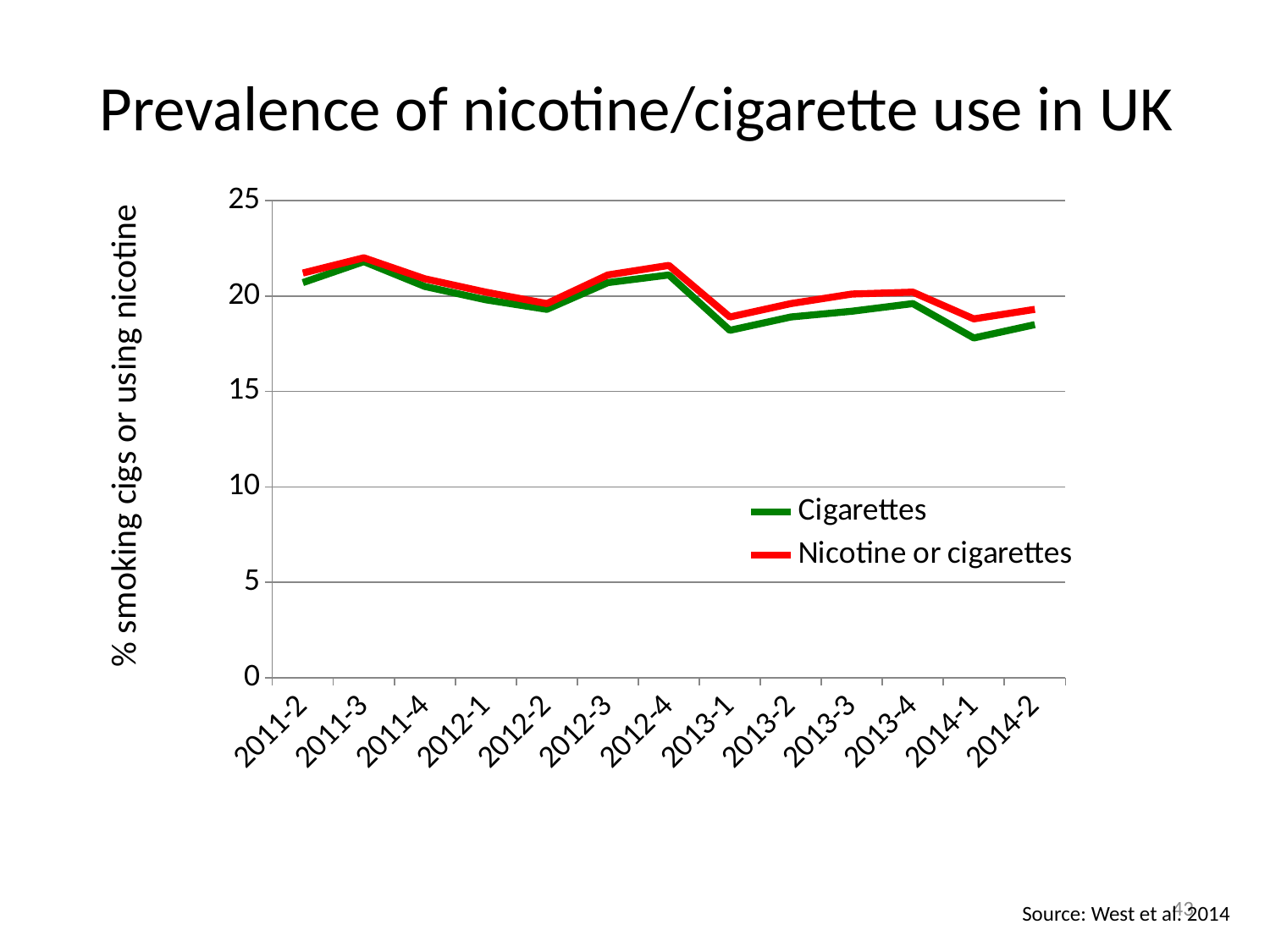
Is the value for Nicotine or cigarettes in 2013-1 greater or less than 20? less Is the value for Cigarettes in 2011-3 greater or less than 20? greater How many time points are plotted along the x axis? 13 Is the value for Nicotine or cigarettes in 2012-4 greater or less than 20? greater At which time point is the Cigarettes series highest? 2011-3 In 2013-3, which is larger: Cigarettes or Nicotine or cigarettes? Nicotine or cigarettes At which time point is the Cigarettes series lowest? 2014-1 Which series is shown in red? Nicotine or cigarettes How many series does the legend list? 2 What kind of chart is shown on the slide? line chart What is the y-axis label of the chart? % smoking cigs or using nicotine